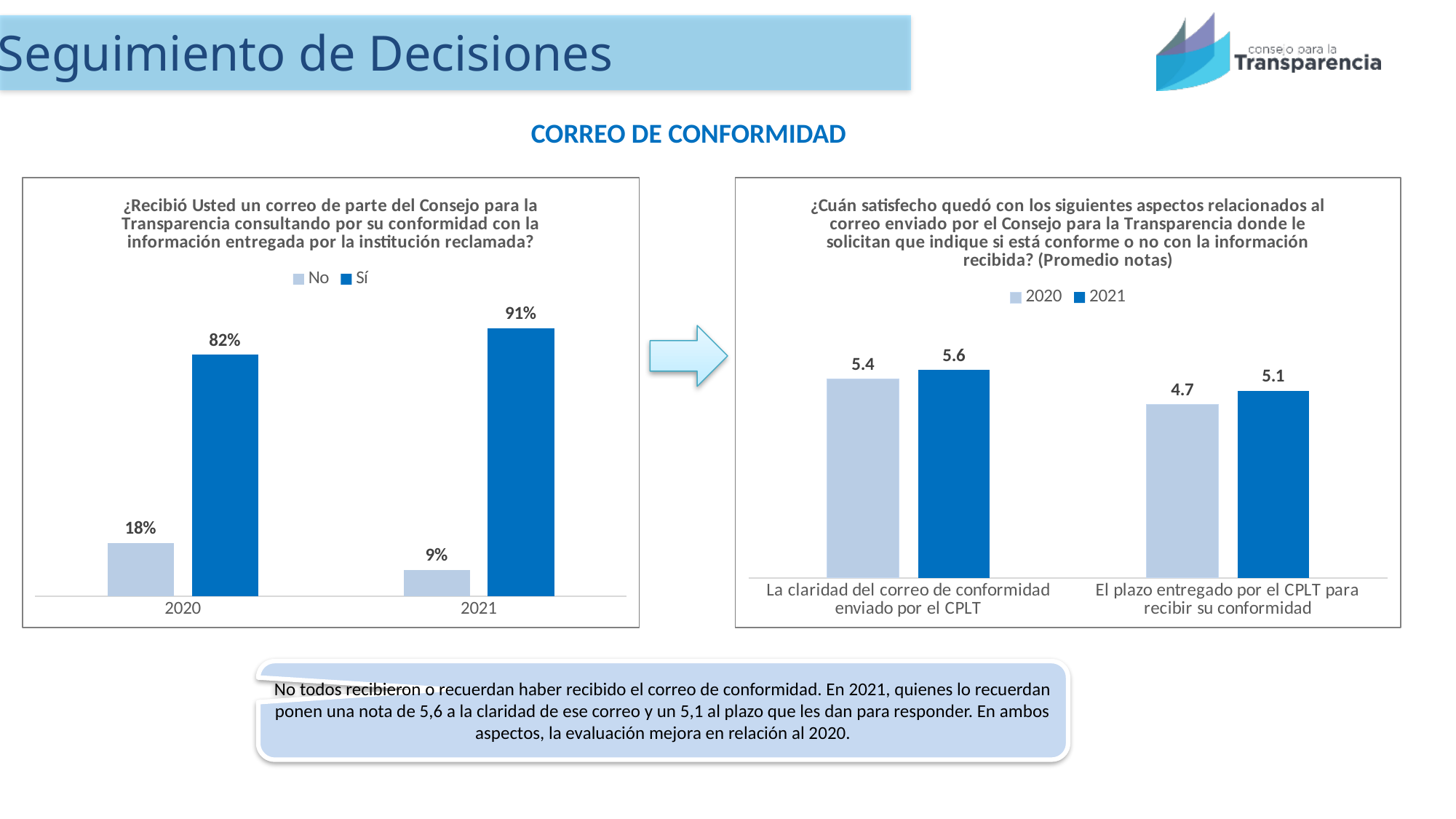
What type of chart is the right chart? bar chart In the left chart, what percentage answered 'Sí' in 2021? 91% In the left chart, what percentage answered 'No' in 2020? 18% In the left chart, does the 'Sí' share rise or fall from 2020 to 2021? rise In the left chart, by how many percentage points did the 'Sí' share change from 2020 to 2021? 9 percentage points In the right chart, what is the 2020 average score for 'El plazo entregado por el CPLT para recibir su conformidad'? 4.7 In the right chart, which aspect has the highest 2021 score? La claridad del correo de conformidad enviado por el CPLT In the left chart, how many series does the legend list? 2 In the right chart, how many categories are shown on the x axis? 2 In the right chart, what is the difference between the 2021 and 2020 scores for 'El plazo entregado por el CPLT para recibir su conformidad'? 0.4 In the right chart, what is the 2021 average score for 'La claridad del correo de conformidad enviado por el CPLT'? 5.6 In the left chart, which year has the lower 'No' percentage? 2021